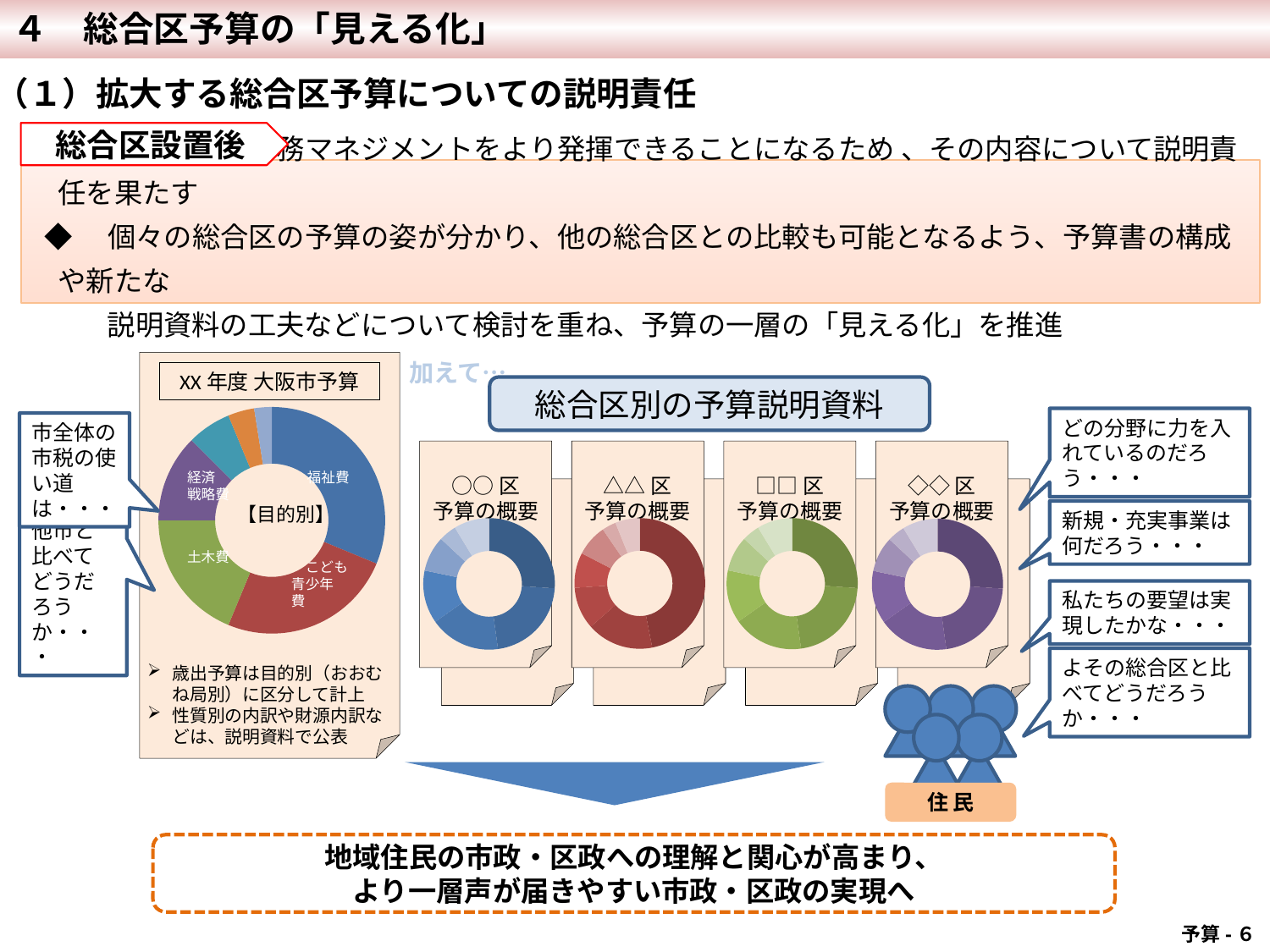
How many labeled categories are shown on the 「XX 年度 大阪市予算」 donut chart? 4 What kind of chart is the 「XX 年度 大阪市予算」 chart on the left of the slide? Donut (pie) chart What colour is the 福祉費 slice in the 「XX 年度 大阪市予算」 donut chart? Blue What kind of charts are shown on the 「○○区 予算の概要」, 「△△区 予算の概要」, 「□□区 予算の概要」 and 「◇◇区 予算の概要」 documents? Donut (pie) charts In the 「XX 年度 大阪市予算」 donut chart, which slice is larger, こども青少年費 or 経済戦略費? こども青少年費 In the 「XX 年度 大阪市予算」 donut chart, which slice is larger, 福祉費 or 土木費? 福祉費 In the 「XX 年度 大阪市予算」 donut chart, which labeled category has the largest slice? 福祉費 In the 「XX 年度 大阪市予算」 donut chart, which slice is larger, 土木費 or 経済戦略費? 土木費 What text is shown in the centre of the 「XX 年度 大阪市予算」 donut chart? 【目的別】 How many small district donut charts are shown under 「総合区別の予算説明資料」? 4